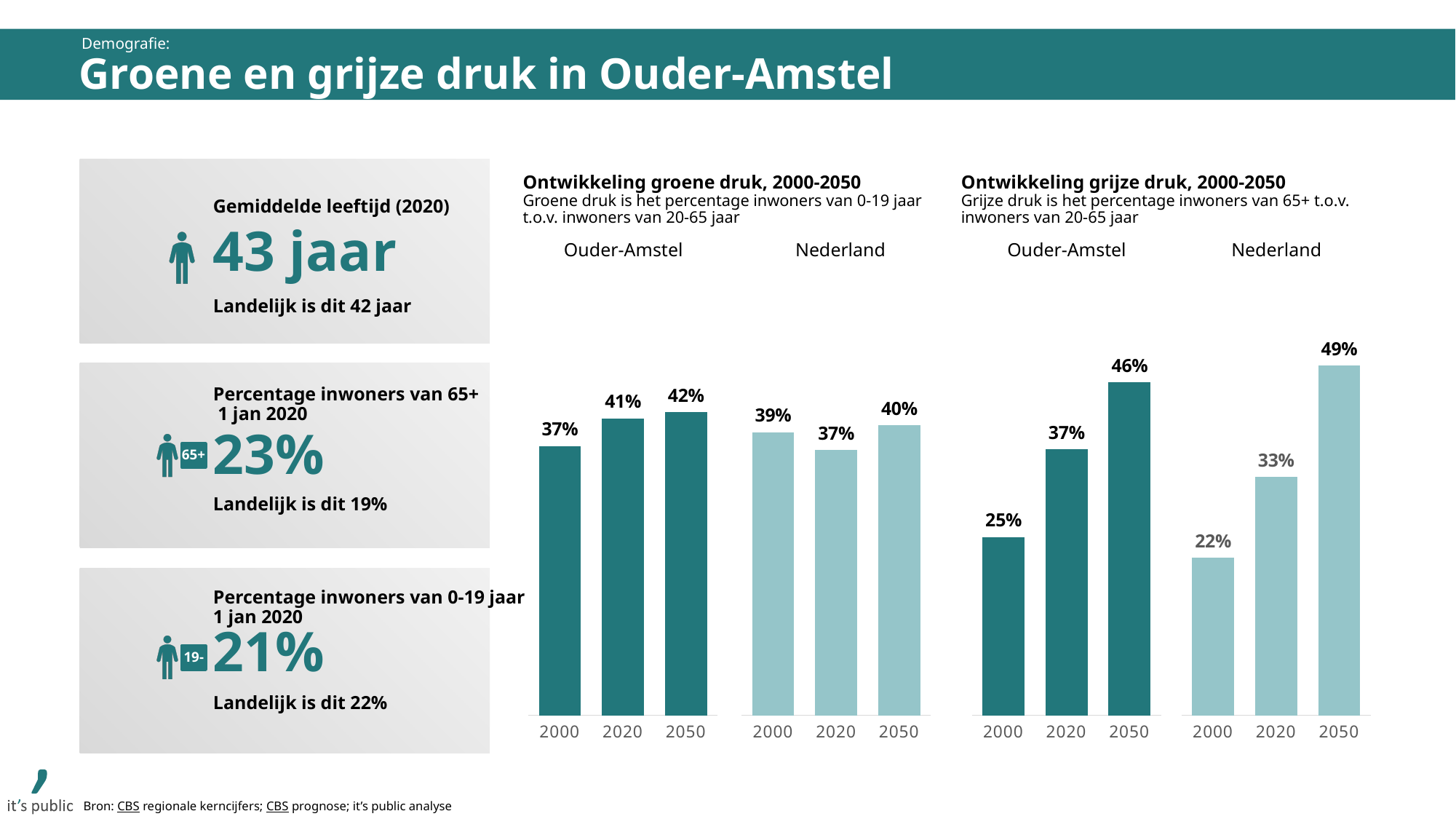
In the 'Ontwikkeling grijze druk, 2000-2050' chart, which year has the highest value for Ouder-Amstel? 2050 In the 'Ontwikkeling grijze druk, 2000-2050' chart, do the Ouder-Amstel values rise or fall from 2000 to 2050? rise In the 'Ontwikkeling groene druk, 2000-2050' chart, which year has the lowest value for Nederland? 2020 How many bars are shown in the 'Ontwikkeling groene druk, 2000-2050' chart? 6 In the 'Ontwikkeling grijze druk, 2000-2050' chart, what is the value for Nederland in 2050? 49% In the 'Ontwikkeling groene druk, 2000-2050' chart, which is larger in 2000: Ouder-Amstel or Nederland? Nederland What kind of chart is 'Ontwikkeling grijze druk, 2000-2050'? bar chart In the 'Ontwikkeling grijze druk, 2000-2050' chart, what is the difference between the Nederland values for 2050 and 2000? 27 percentage points In the 'Ontwikkeling grijze druk, 2000-2050' chart, which is larger in 2020: Ouder-Amstel or Nederland? Ouder-Amstel In the 'Ontwikkeling groene druk, 2000-2050' chart, what is the difference between the Ouder-Amstel and Nederland values for 2050? 2 percentage points In the 'Ontwikkeling groene druk, 2000-2050' chart, what is the value for Ouder-Amstel in 2020? 41% In the 'Ontwikkeling grijze druk, 2000-2050' chart, what is the value for Ouder-Amstel in 2000? 25%